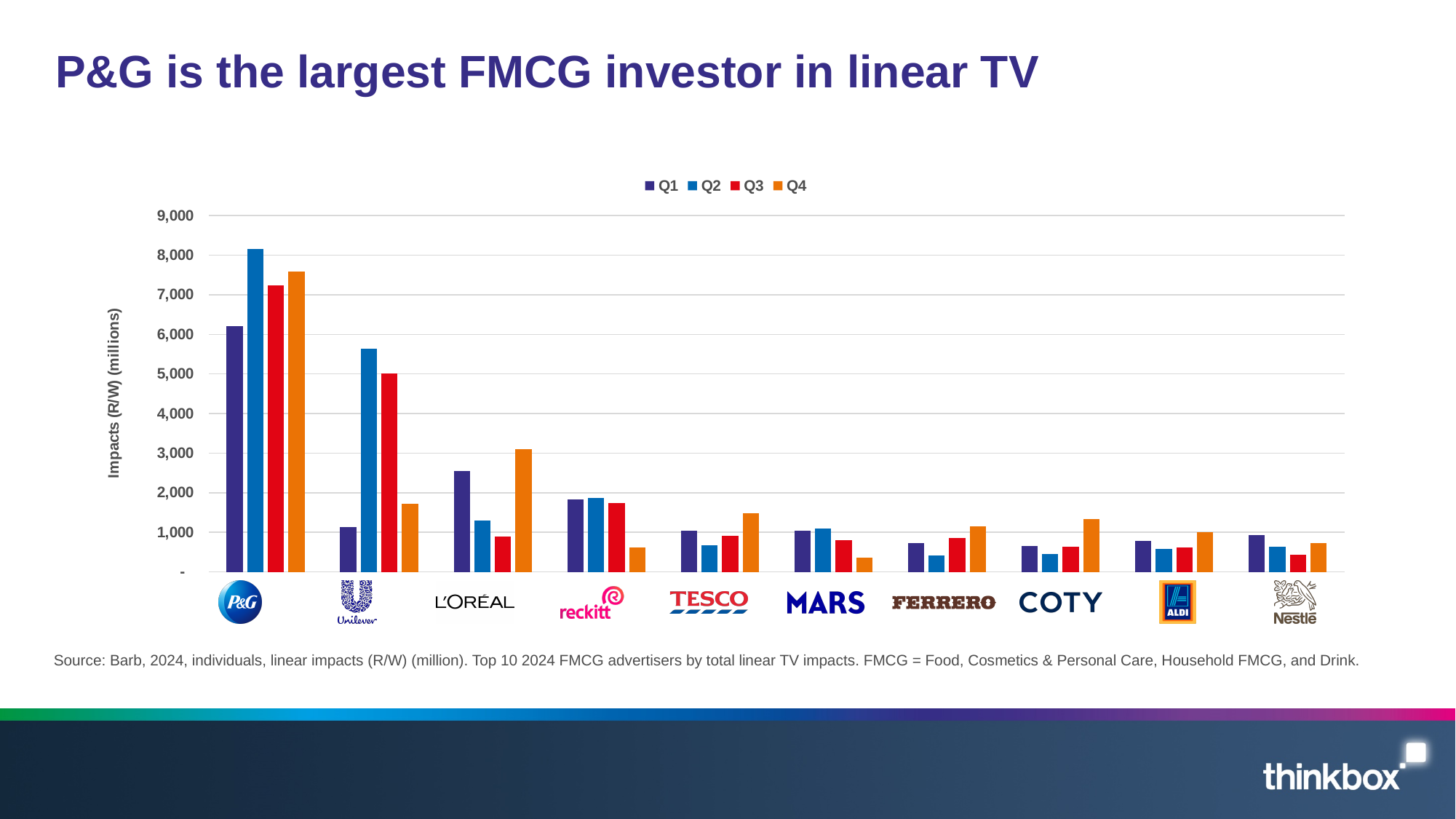
Which quarter has the lowest value for Unilever? Q1 Is the Q2 value for P&G greater or less than 8,000? greater Is the Q4 value for Mars greater or less than 1,000? less Which quarter has the highest value for P&G? Q2 For Unilever, which is larger: the Q2 value or the Q3 value? Q2 How many series does the legend list? 4 Which quarter has the highest value for L'Oréal? Q4 How many advertisers (brands) are shown along the x axis? 10 Is the Q4 value for Coty greater or less than 1,000? greater What kind of chart is shown on the slide? Bar chart